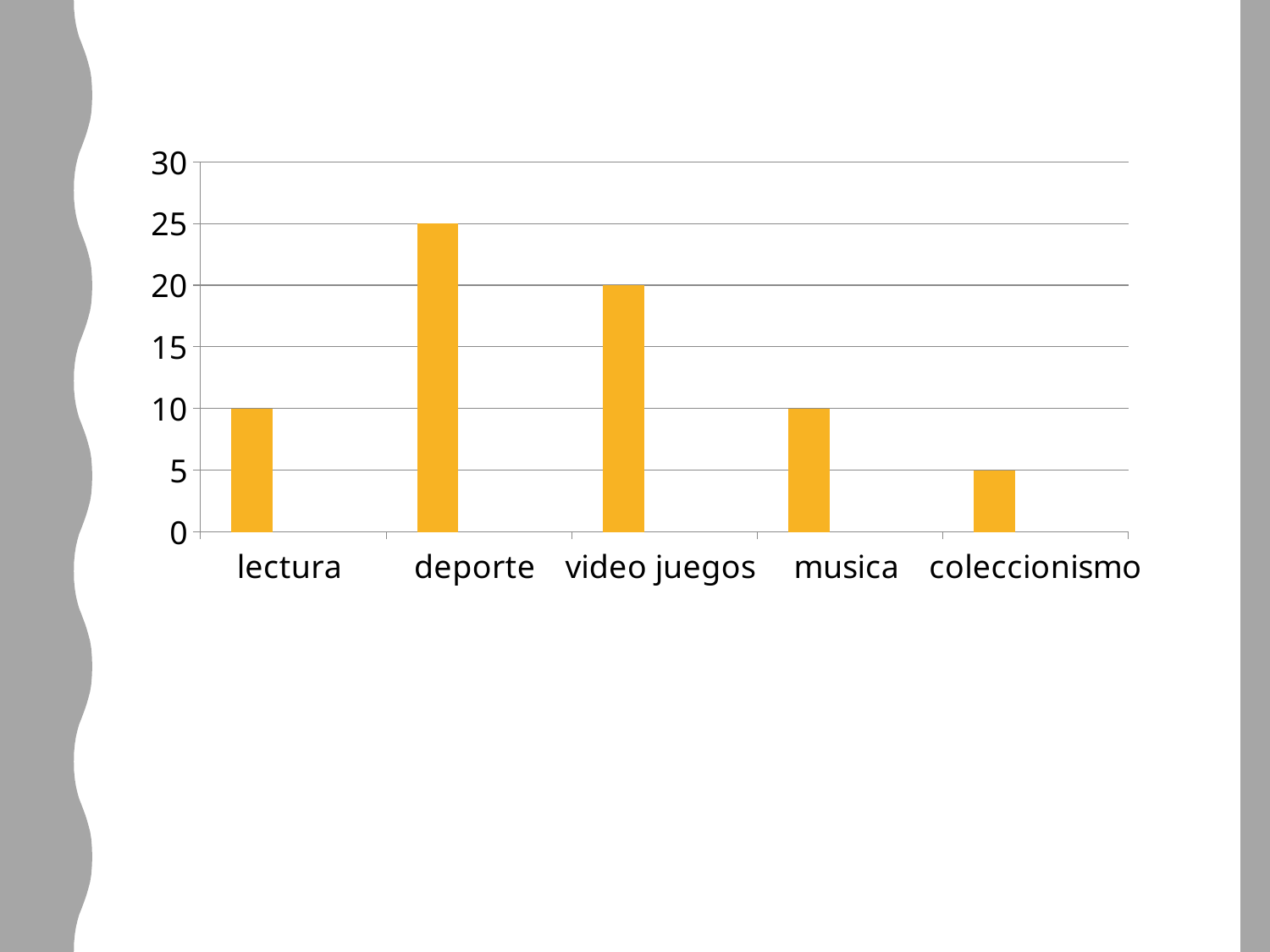
What is the value for lectura? 10 What is the value for coleccionismo? 5 What is the difference between the values for musica and coleccionismo? 5 What kind of chart is shown on the slide? bar chart Which is larger, the value for video juegos or the value for lectura? video juegos How many categories are shown on the x axis? 5 What is the value for deporte? 25 What colour are the bars in the chart? orange Which category has the highest value? deporte What is the value for video juegos? 20 Which category has the lowest value? coleccionismo What is the difference between the values for deporte and video juegos? 5